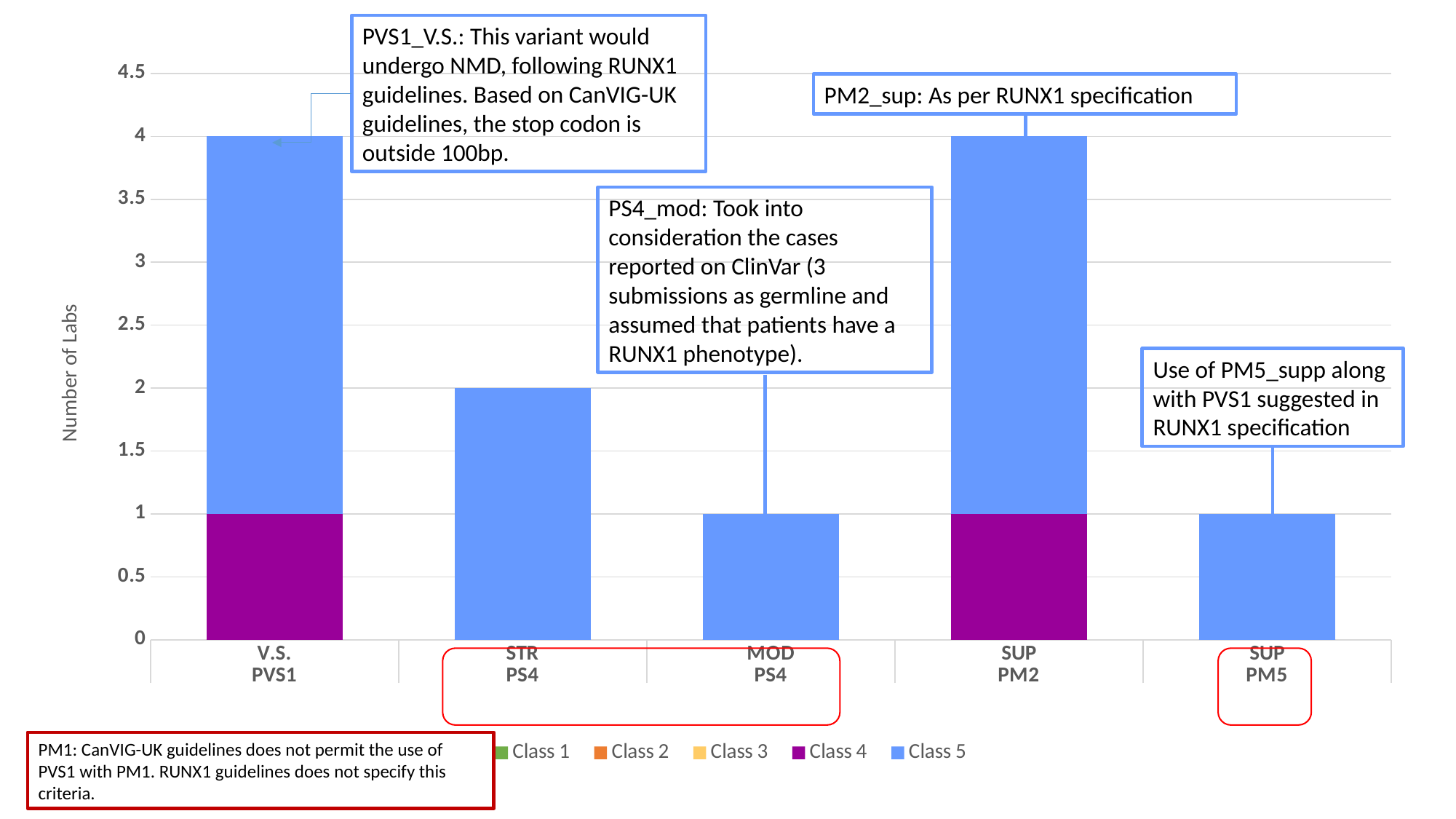
What is the label of the chart's y axis? Number of Labs How many categories are shown on the x axis of the chart? 5 What is the difference between the total for V.S. PVS1 and the value for STR PS4? 2 How many series does the chart's legend list? 5 Which is larger, the value for STR PS4 or the value for MOD PS4? STR PS4 Is the value for SUP PM5 greater or less than 2? less What is the total height of the stacked bar for SUP PM2? 4 What is the total height of the stacked bar for V.S. PVS1? 4 What is the value for STR PS4? 2 What kind of chart is shown on the slide? bar chart What is the value for MOD PS4? 1 What is the Class 4 value in the V.S. PVS1 bar? 1